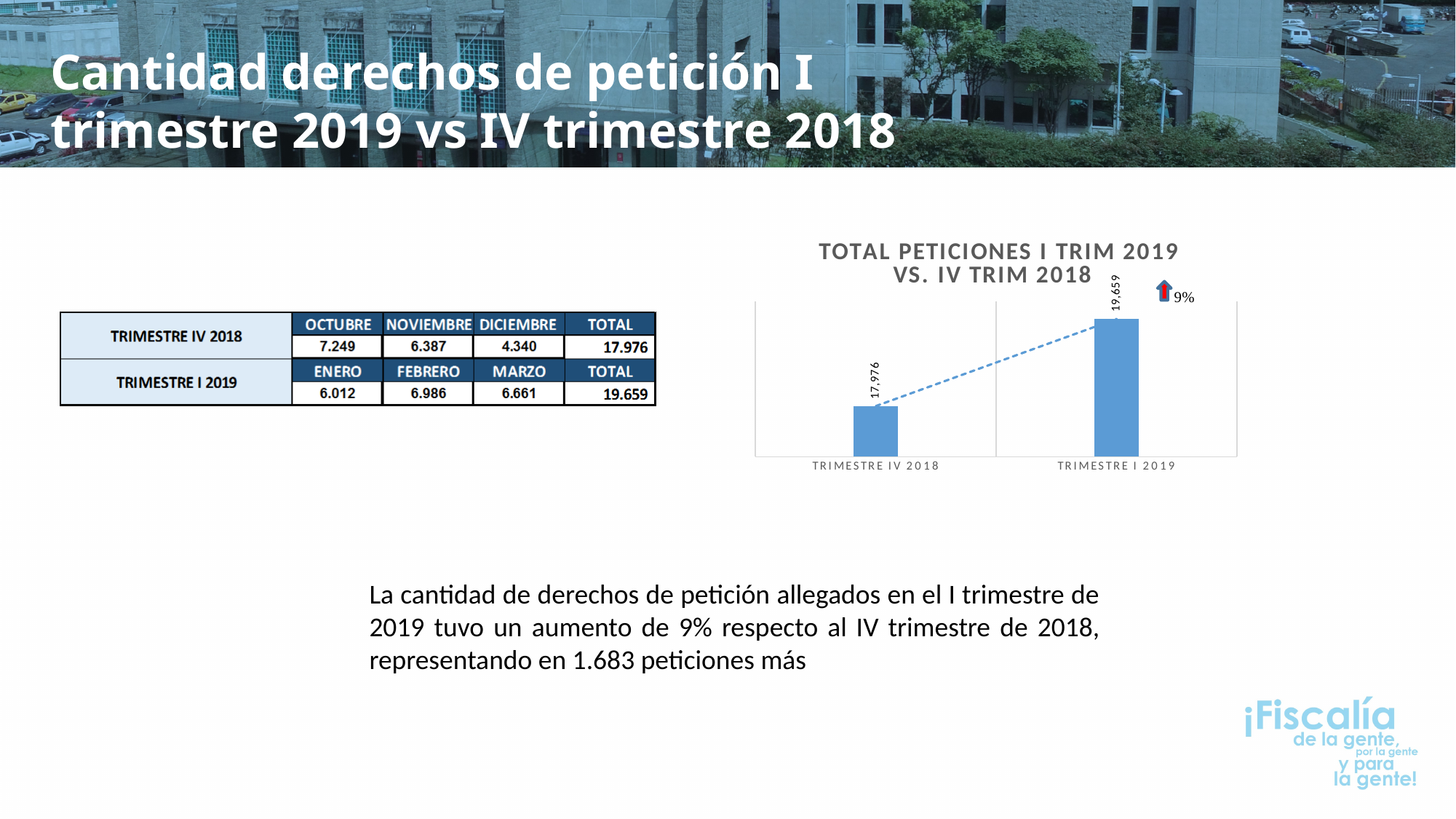
Which is larger, the value for TRIMESTRE IV 2018 or the value for TRIMESTRE I 2019? TRIMESTRE I 2019 Which category has the lowest value in the chart? TRIMESTRE IV 2018 What is the value for TRIMESTRE I 2019 in the chart? 19,659 How many categories are shown in the chart? 2 Do the values rise or fall from TRIMESTRE IV 2018 to TRIMESTRE I 2019? Rise What is the title of the chart? TOTAL PETICIONES I TRIM 2019 VS. IV TRIM 2018 What percentage change is annotated next to the arrow above the chart? 9% What kind of chart is shown on the slide? Bar chart What is the difference between the values for TRIMESTRE I 2019 and TRIMESTRE IV 2018? 1,683 What is the value for TRIMESTRE IV 2018 in the chart? 17,976 Which category has the highest value in the chart? TRIMESTRE I 2019